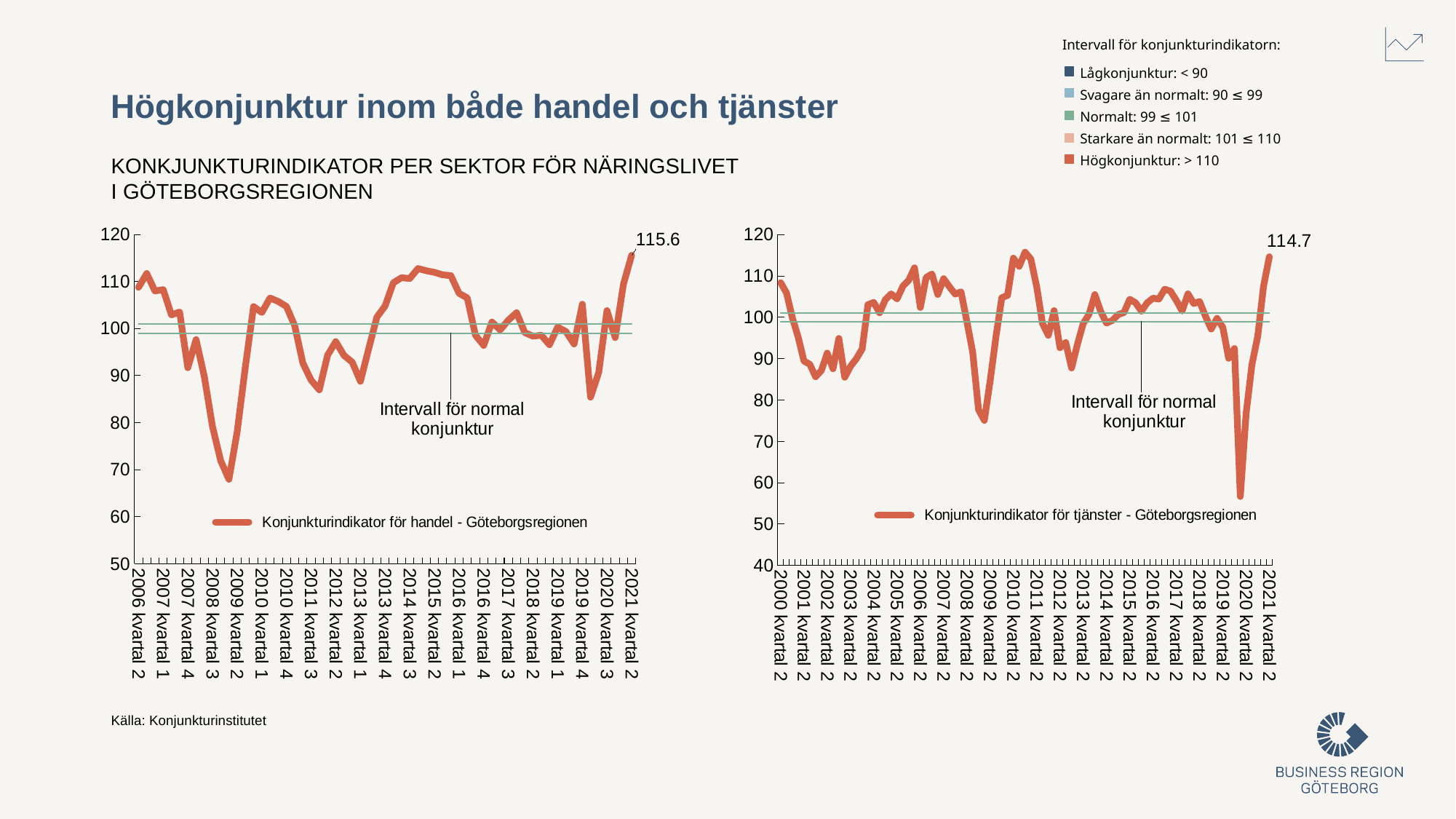
On the right chart, is the value for 2020 kvartal 2 greater or less than 60? greater On the left chart, is the value for 2009 kvartal 2 greater or less than 80? less On the left chart, is the value for 2019 kvartal 4 greater or less than 90? greater What is the lowest value shown on the y axis of the right chart? 40 What kind of chart is the left chart (Konjunkturindikator för handel)? line chart What is the difference between the 2021 kvartal 2 values on the left chart (115.6) and the right chart (114.7)? 0.9 On the right chart, what is the value of Konjunkturindikator för tjänster for 2021 kvartal 2? 114.7 Which is larger: the 2021 kvartal 2 value on the left chart (handel) or on the right chart (tjänster)? handel (115.6) How many data series does the legend of the right chart list? 1 On the left chart, what is the value of Konjunkturindikator för handel for 2021 kvartal 2? 115.6 What is the legend label of the series on the left chart? Konjunkturindikator för handel - Göteborgsregionen